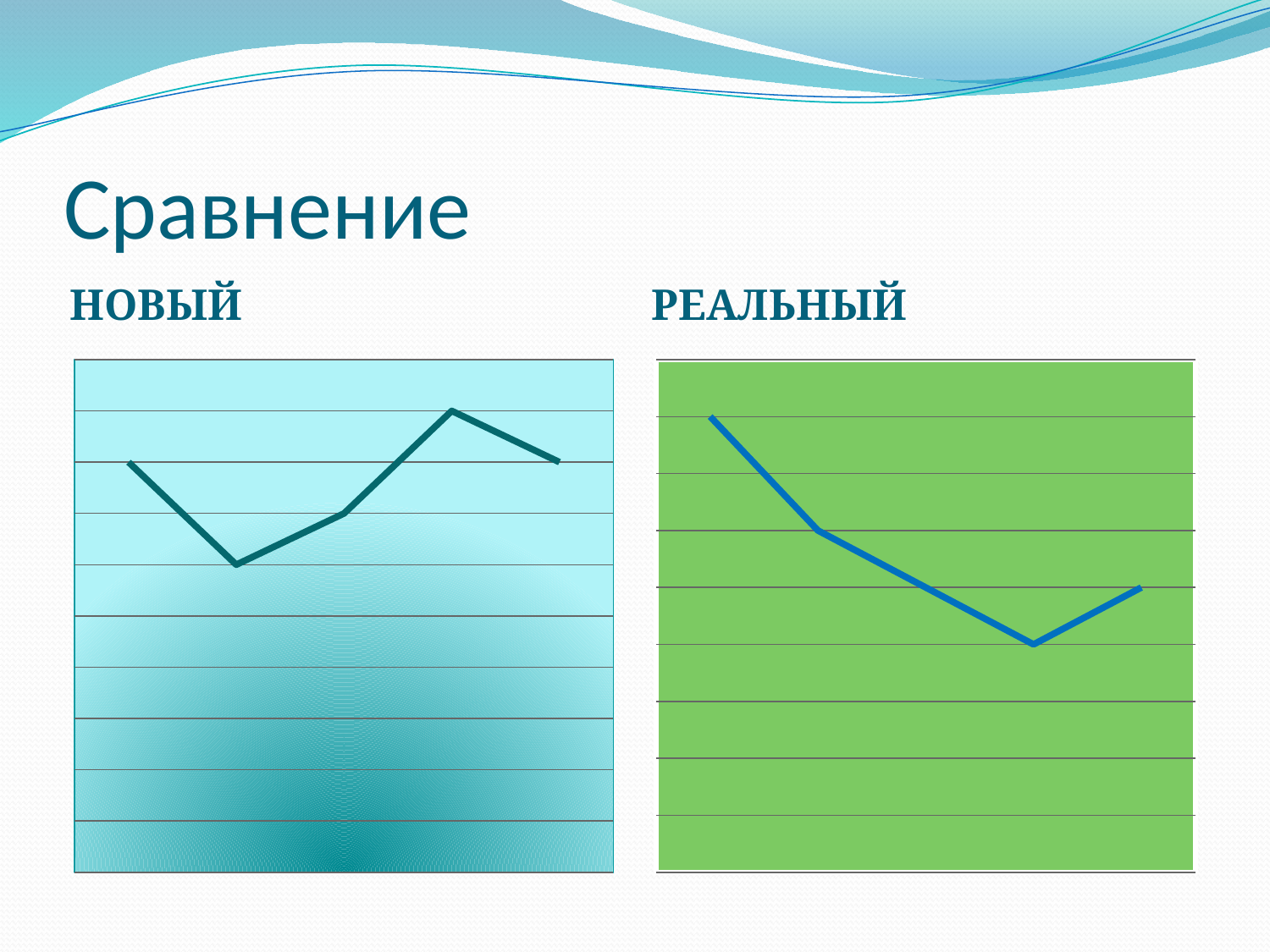
In the right chart (РЕАЛЬНЫЙ), which point is the lowest: the first, second, third, fourth or fifth? fourth In the left chart (НОВЫЙ), which is higher, the first point or the second point? the first point In the right chart (РЕАЛЬНЫЙ), how many data points does the line have? 5 What is the heading above the right-hand chart? РЕАЛЬНЫЙ In the left chart (НОВЫЙ), which point is the highest: the first, second, third, fourth or fifth? fourth In the left chart (НОВЫЙ), how many data points does the line have? 5 In the right chart (РЕАЛЬНЫЙ), which is higher, the fourth point or the fifth point? the fifth point What kind of chart is shown under the heading НОВЫЙ on the left? line chart In the left chart (НОВЫЙ), which point is the lowest: the first, second, third, fourth or fifth? second In the right chart (РЕАЛЬНЫЙ), do the values rise or fall from the first point to the fourth point? fall In the right chart (РЕАЛЬНЫЙ), which point is the highest: the first, second, third, fourth or fifth? first What kind of chart is shown under the heading РЕАЛЬНЫЙ on the right? line chart